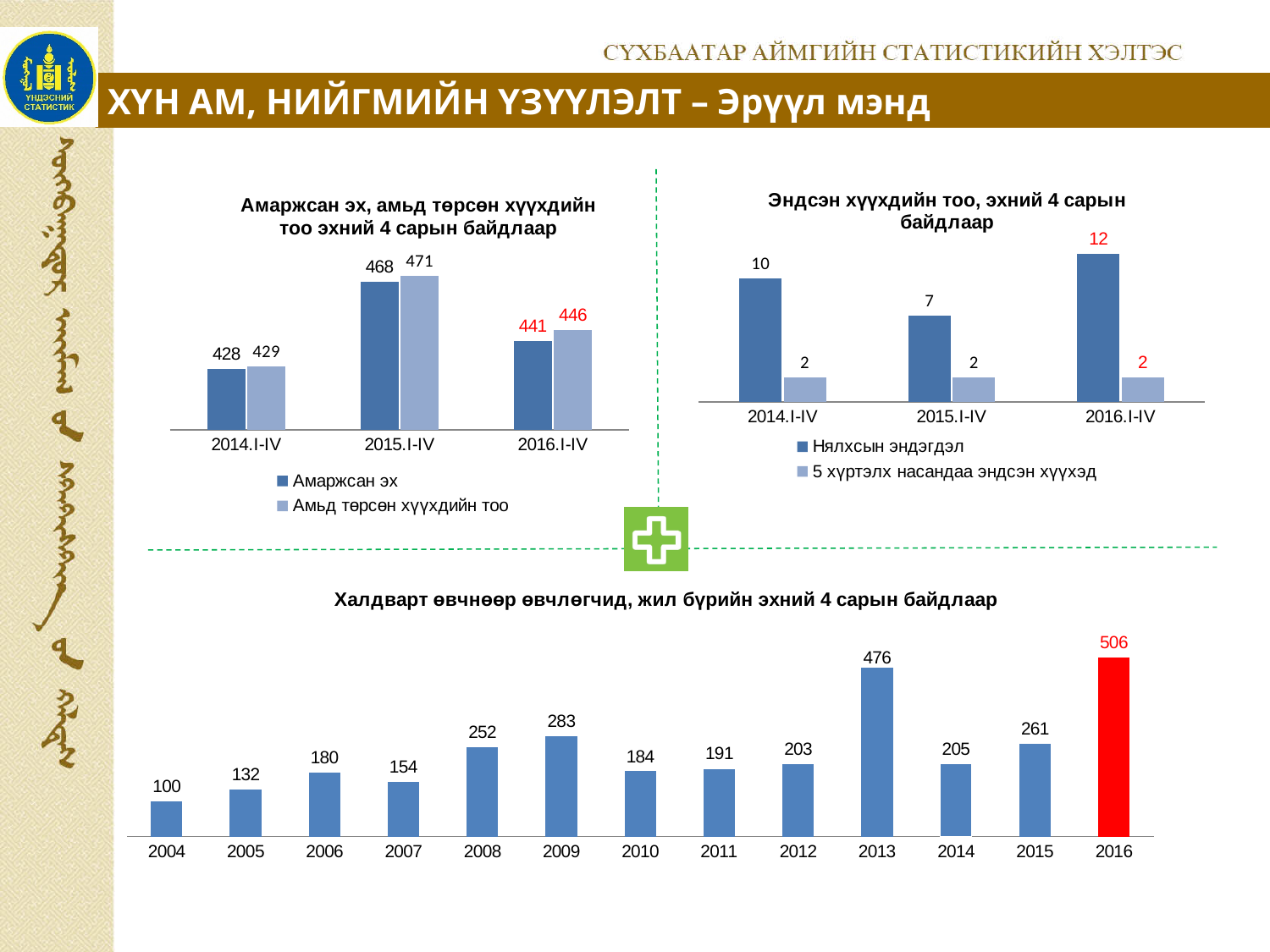
In the top-right chart 'Эндсэн хүүхдийн тоо, эхний 4 сарын байдлаар', what is the value of 'Нялхсын эндэгдэл' for 2016.I-IV? 12 What type of chart is the bottom chart 'Халдварт өвчнөөр өвчлөгчид, жил бүрийн эхний 4 сарын байдлаар'? Bar chart In the top-left chart 'Амаржсан эх, амьд төрсөн хүүхдийн тоо эхний 4 сарын байдлаар', how many series does the legend list? 2 In the top-left chart 'Амаржсан эх, амьд төрсөн хүүхдийн тоо эхний 4 сарын байдлаар', what is the value of 'Амьд төрсөн хүүхдийн тоо' for 2016.I-IV? 446 In the top-left chart 'Амаржсан эх, амьд төрсөн хүүхдийн тоо эхний 4 сарын байдлаар', what is the value of 'Амаржсан эх' for 2015.I-IV? 468 In the bottom chart 'Халдварт өвчнөөр өвчлөгчид, жил бүрийн эхний 4 сарын байдлаар', which year has the lowest value? 2004 In the bottom chart 'Халдварт өвчнөөр өвчлөгчид, жил бүрийн эхний 4 сарын байдлаар', which year has the highest value? 2016 In the top-left chart 'Амаржсан эх, амьд төрсөн хүүхдийн тоо эхний 4 сарын байдлаар', what is the difference between 'Амьд төрсөн хүүхдийн тоо' and 'Амаржсан эх' in 2014.I-IV? 1 In the top-right chart 'Эндсэн хүүхдийн тоо, эхний 4 сарын байдлаар', which period has the lowest value for 'Нялхсын эндэгдэл'? 2015.I-IV In the bottom chart 'Халдварт өвчнөөр өвчлөгчид, жил бүрийн эхний 4 сарын байдлаар', what is the value for 2013? 476 In the top-right chart 'Эндсэн хүүхдийн тоо, эхний 4 сарын байдлаар', what is the difference between 'Нялхсын эндэгдэл' and '5 хүртэлх насандаа эндсэн хүүхэд' in 2014.I-IV? 8 In the bottom chart 'Халдварт өвчнөөр өвчлөгчид, жил бүрийн эхний 4 сарын байдлаар', how many years are shown on the x axis? 13